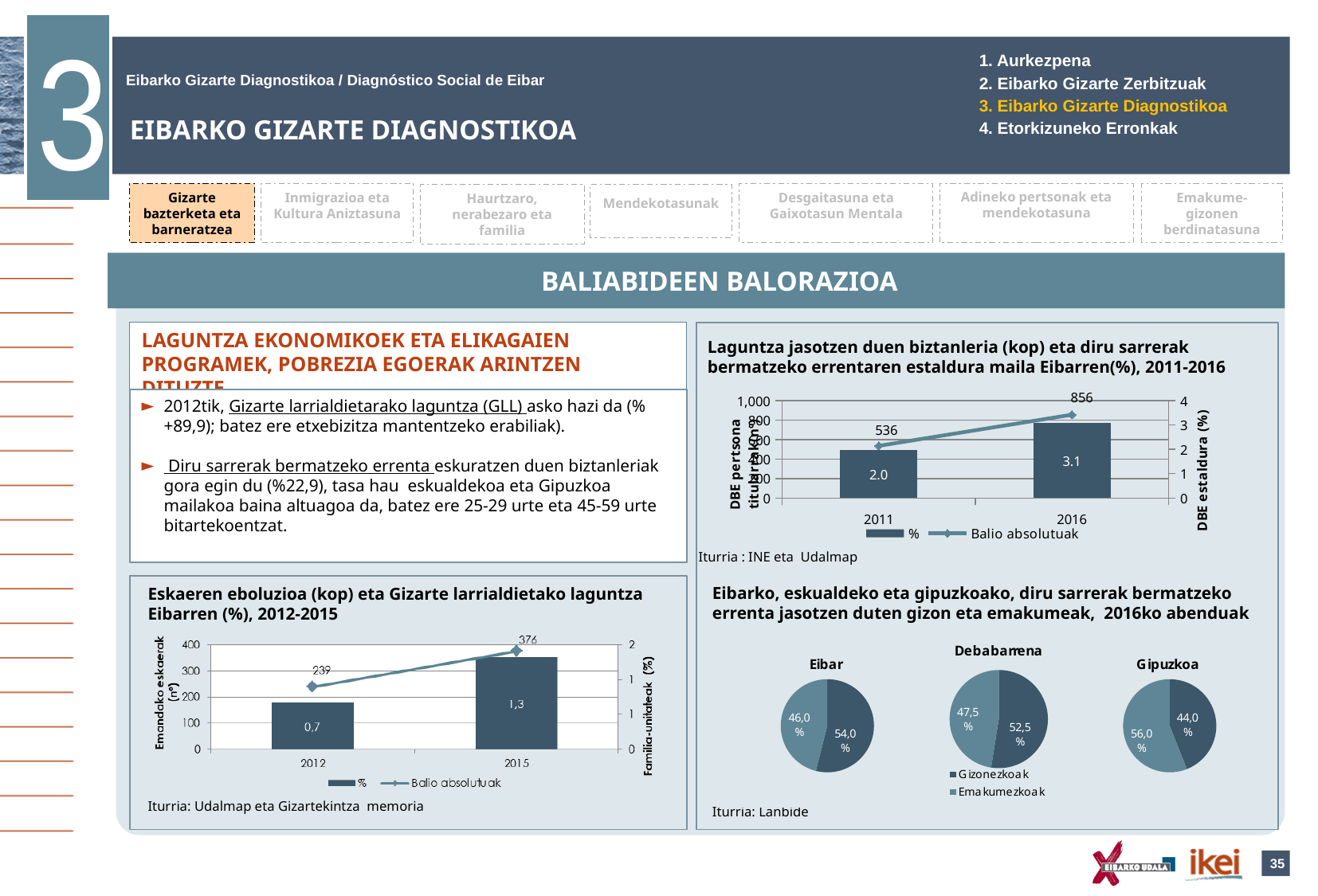
In the bottom-left chart (Eskaeren eboluzioa, 2012-2015), what is the difference between the Balio absolutuak values for 2015 and 2012? 137 In the bottom-left chart (Eskaeren eboluzioa, 2012-2015), how many years are shown on the x axis? 2 In the bottom-left chart (Eskaeren eboluzioa, 2012-2015), what is the % value for 2015? 1,3 In the bottom-right pie charts, what is the Gizonezkoak share in the Eibar pie? 54,0% In the top-right chart (Laguntza jasotzen duen biztanleria, 2011-2016), what is the Balio absolutuak value for 2016? 856 In the top-right chart (Laguntza jasotzen duen biztanleria, 2011-2016), does the % value rise or fall from 2011 to 2016? rise In the bottom-left chart (Eskaeren eboluzioa, 2012-2015), what is the Balio absolutuak value for 2012? 239 In the top-right chart (Laguntza jasotzen duen biztanleria, 2011-2016), how many series does the legend list? 2 In the top-right chart (Laguntza jasotzen duen biztanleria, 2011-2016), by how much did the Balio absolutuak value increase from 2011 to 2016? 320 In the bottom-right pie charts, what is the larger slice's share in the Gipuzkoa pie? 56,0% In the top-right chart (Laguntza jasotzen duen biztanleria, 2011-2016), what is the % value for 2011? 2.0 What kind of charts are shown in the bottom-right panel (Eibar, Debabarrena, Gipuzkoa)? pie charts